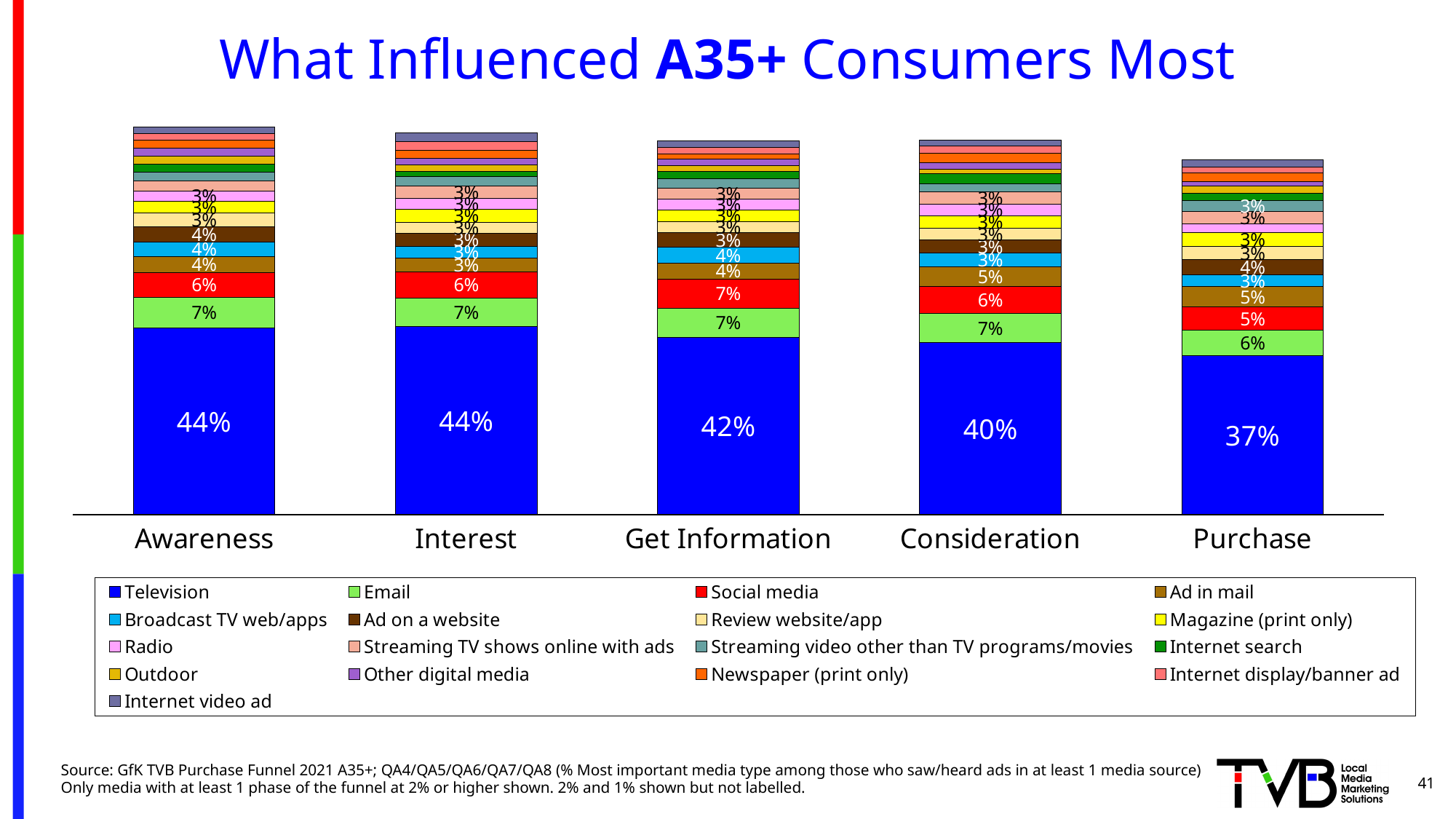
Which is larger: the Social media value for Get Information or the Social media value for Purchase? Get Information What kind of chart is shown on the slide? Stacked bar chart What is the Email value for the Purchase stage? 6% Does the Television value rise or fall from Awareness to Purchase? Fall What is the Ad in mail value for the Consideration stage? 5% How many series does the legend list? 17 What is the Television value for the Awareness stage? 44% What is the difference between the Television value for Awareness and the Television value for Purchase? 7% What is the Social media value for the Get Information stage? 7% What is the Television value for the Purchase stage? 37% Which funnel stage has the lowest Television value? Purchase How many funnel stages are shown on the x axis? 5